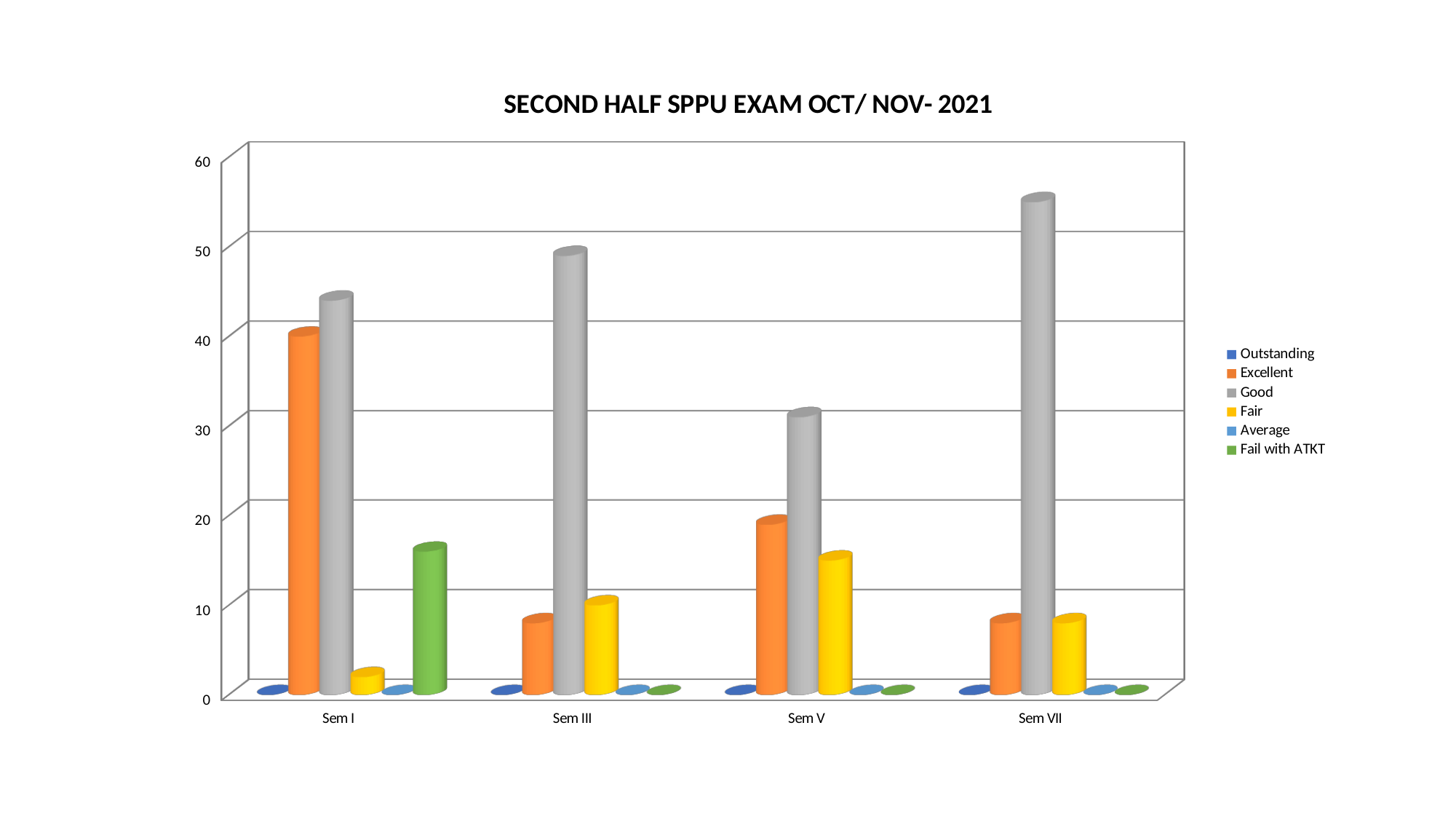
What kind of chart is shown on the slide? Bar chart Is the Fail with ATKT value for Sem I greater or less than 10? greater Which semester has the lowest Good value? Sem V Which semester has the highest Fail with ATKT value? Sem I Which semester has the highest Good value? Sem VII What is the title of the chart? SECOND HALF SPPU EXAM OCT/ NOV- 2021 Is the Good value for Sem III greater or less than 40? greater In Sem I, which is larger, the Excellent value or the Good value? Good How many series does the legend list? 6 Is the Excellent value for Sem V greater or less than 10? greater How many semesters are shown on the x axis? 4